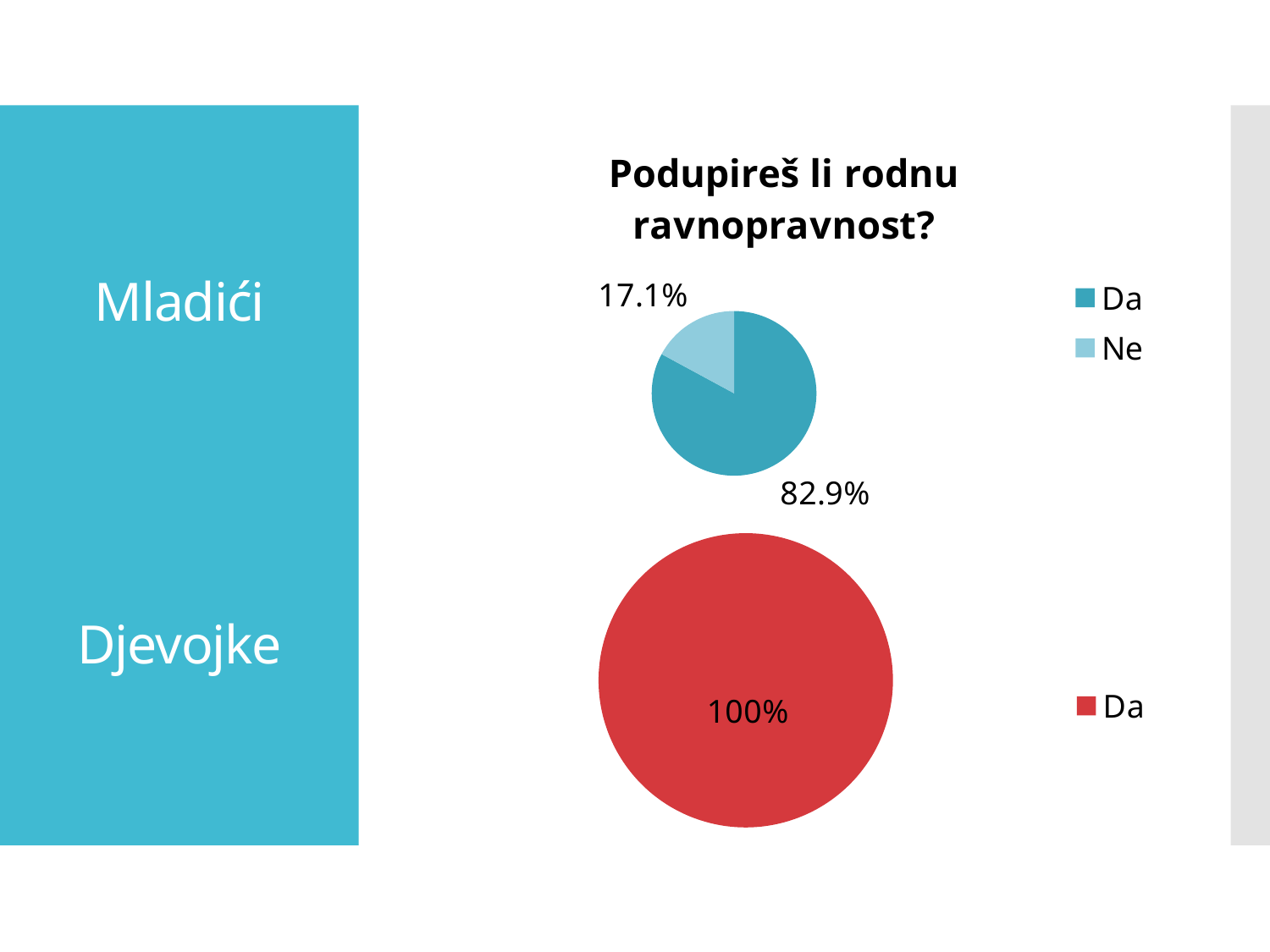
In the top pie chart titled 'Podupireš li rodnu ravnopravnost?', what share of the pie is 'Ne'? 17.1% How many entries does the legend of the top pie chart list? 2 In the top pie chart, which slice is the smallest? Ne In the top pie chart, what is the difference between the 'Da' and 'Ne' shares? 65.8% What colour is the 'Da' slice in the bottom pie chart? Red In the top pie chart, which slice is the largest? Da In the top pie chart titled 'Podupireš li rodnu ravnopravnost?', what share of the pie is 'Da'? 82.9% What type of chart is the top chart on the slide? Pie chart In the bottom pie chart (next to 'Djevojke'), what share of the pie is 'Da'? 100% What is the title of the top pie chart? Podupireš li rodnu ravnopravnost? In the top pie chart, which is larger, 'Da' or 'Ne'? Da How many entries does the legend of the bottom pie chart list? 1